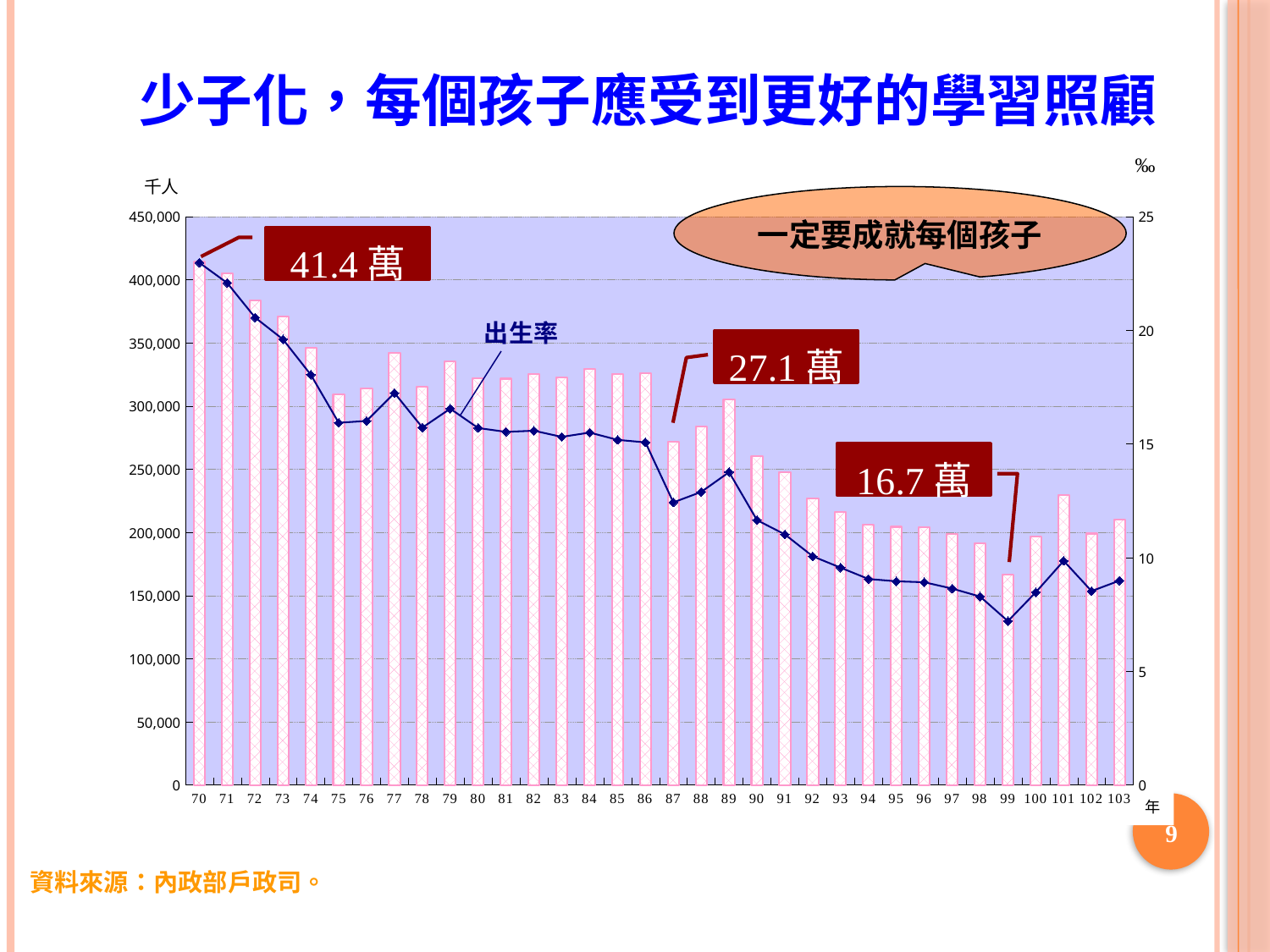
What value does the callout give for the bar at year 99? 16.7 萬 What kind of chart is shown on the slide? A combined bar and line chart Which year has the highest bar? 70 Which is larger, the bar for year 70 or the bar for year 103? Year 70 How many years are shown on the x axis? 34 What value does the callout give for the bar at year 70? 41.4 萬 Is the bar value for year 101 greater or less than 200,000? greater What is the overall trend of the birth rate line from year 70 to year 103? Falling What is the difference between the callout values for year 70 and year 99? 24.7 萬 Is the birth rate (出生率) line value for year 99 greater or less than 10‰? less What value does the callout give for the bar at year 87? 27.1 萬 Which year has the lowest bar? 99